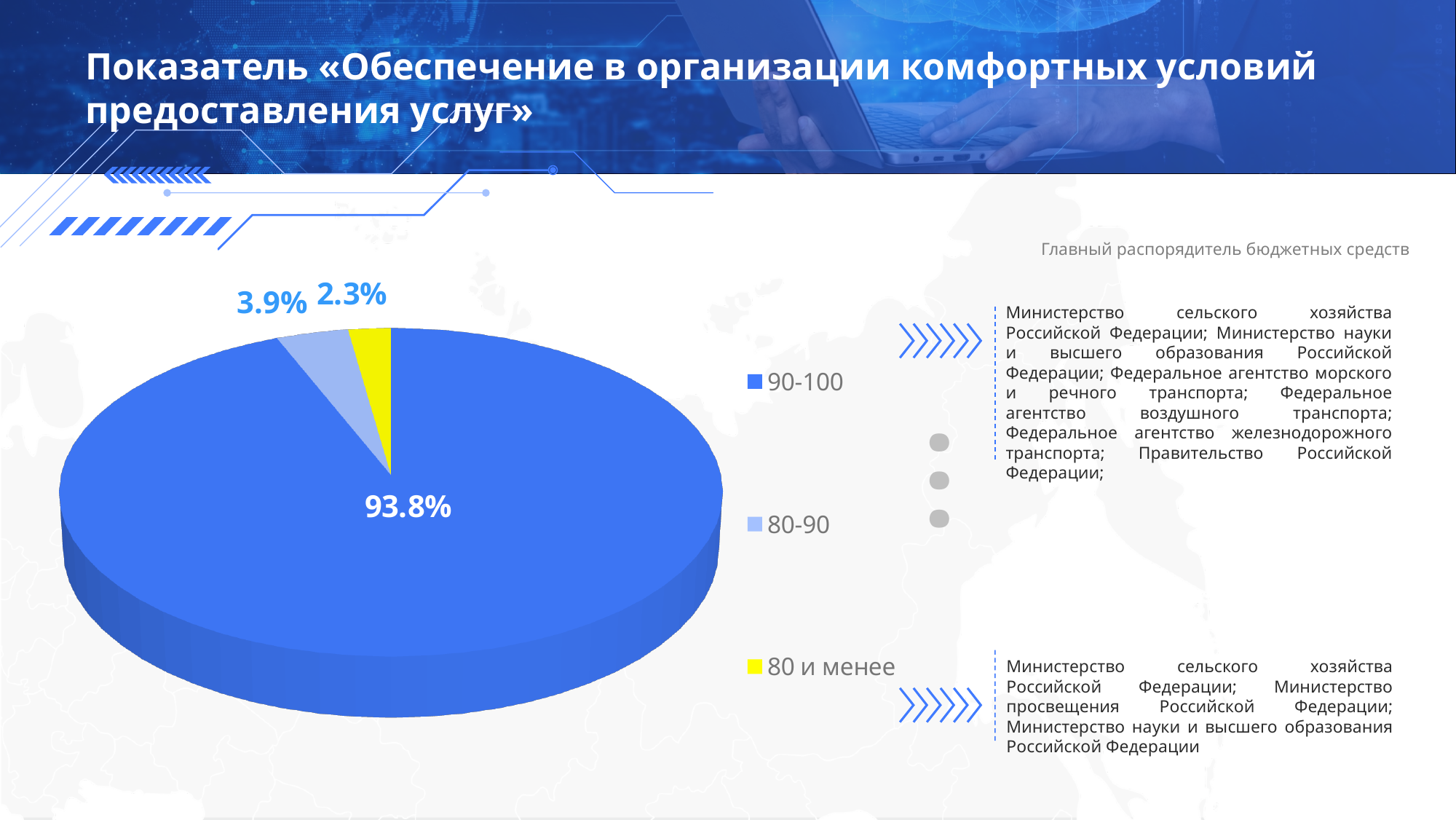
What kind of chart is shown on the slide? pie chart What colour is the "80 и менее" slice in the pie chart? yellow What share of the pie does the "90-100" category have? 93.8% What is the combined share of the "80-90" and "80 и менее" slices? 6.2% Which category has the largest slice of the pie? 90-100 How many slices does the pie chart have? 3 Which category has the smallest slice of the pie? 80 и менее What share of the pie does the "80 и менее" category have? 2.3% How many entries does the legend list? 3 What is the difference in percentage points between the "80-90" slice and the "80 и менее" slice? 1.6 Which slice is larger, "80-90" or "80 и менее"? 80-90 What share of the pie does the "80-90" category have? 3.9%